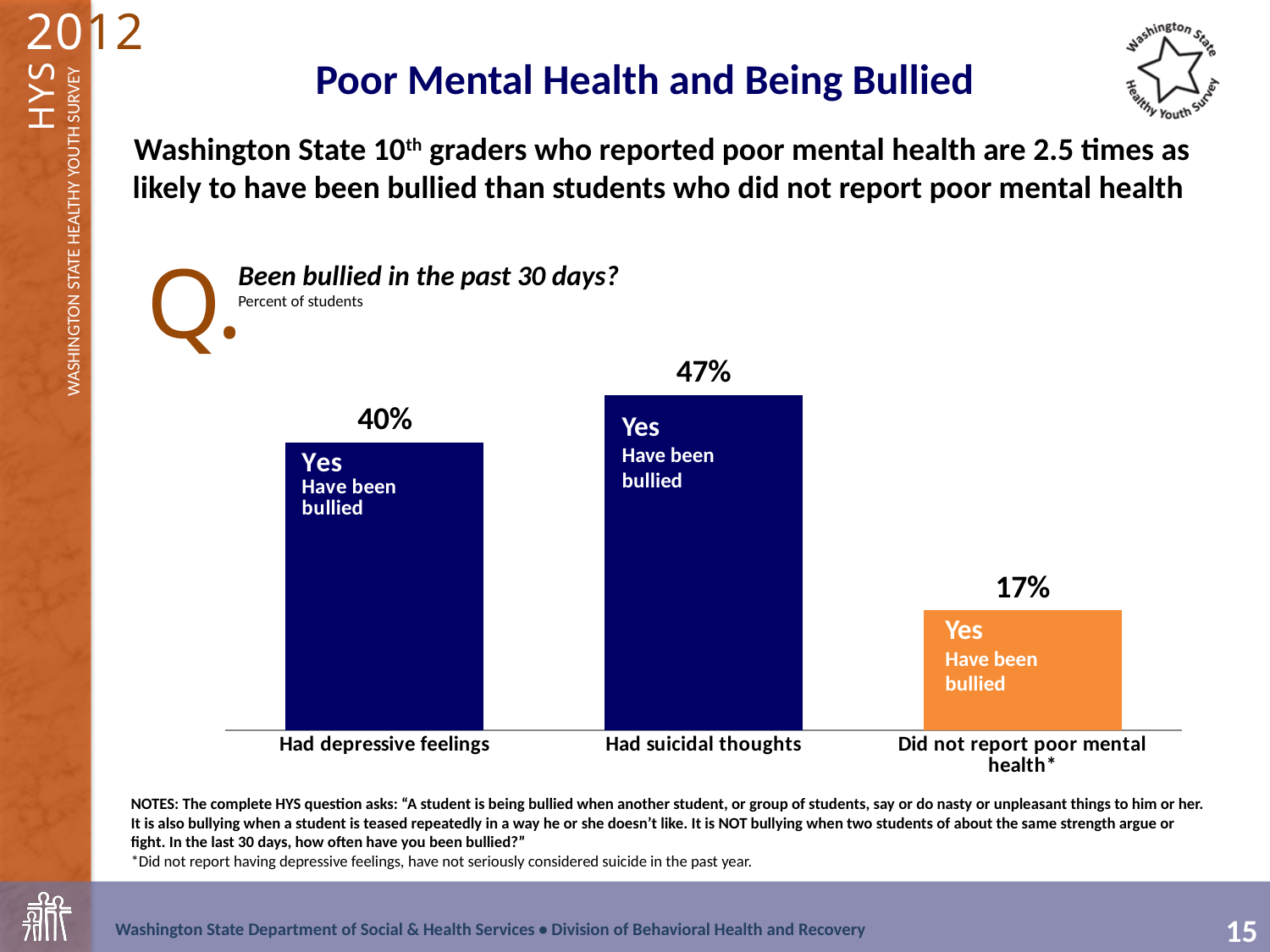
What question does the chart's title ask? Been bullied in the past 30 days? What percent of students who had depressive feelings reported having been bullied in the past 30 days? 40% Which is larger: the value for 'Had depressive feelings' or the value for 'Did not report poor mental health'? Had depressive feelings What kind of chart is shown on the slide? Bar chart What is the difference in percentage points between students who had suicidal thoughts and students who did not report poor mental health? 30 What percent of students who had suicidal thoughts reported having been bullied in the past 30 days? 47% What percent of students who did not report poor mental health reported having been bullied? 17% Which bar is coloured orange rather than dark blue? Did not report poor mental health* What is the difference in percentage points between students who had suicidal thoughts and students who had depressive feelings? 7 How many categories are shown on the chart? 3 Which category has the highest percentage of students who have been bullied? Had suicidal thoughts Which category has the lowest percentage of students who have been bullied? Did not report poor mental health*